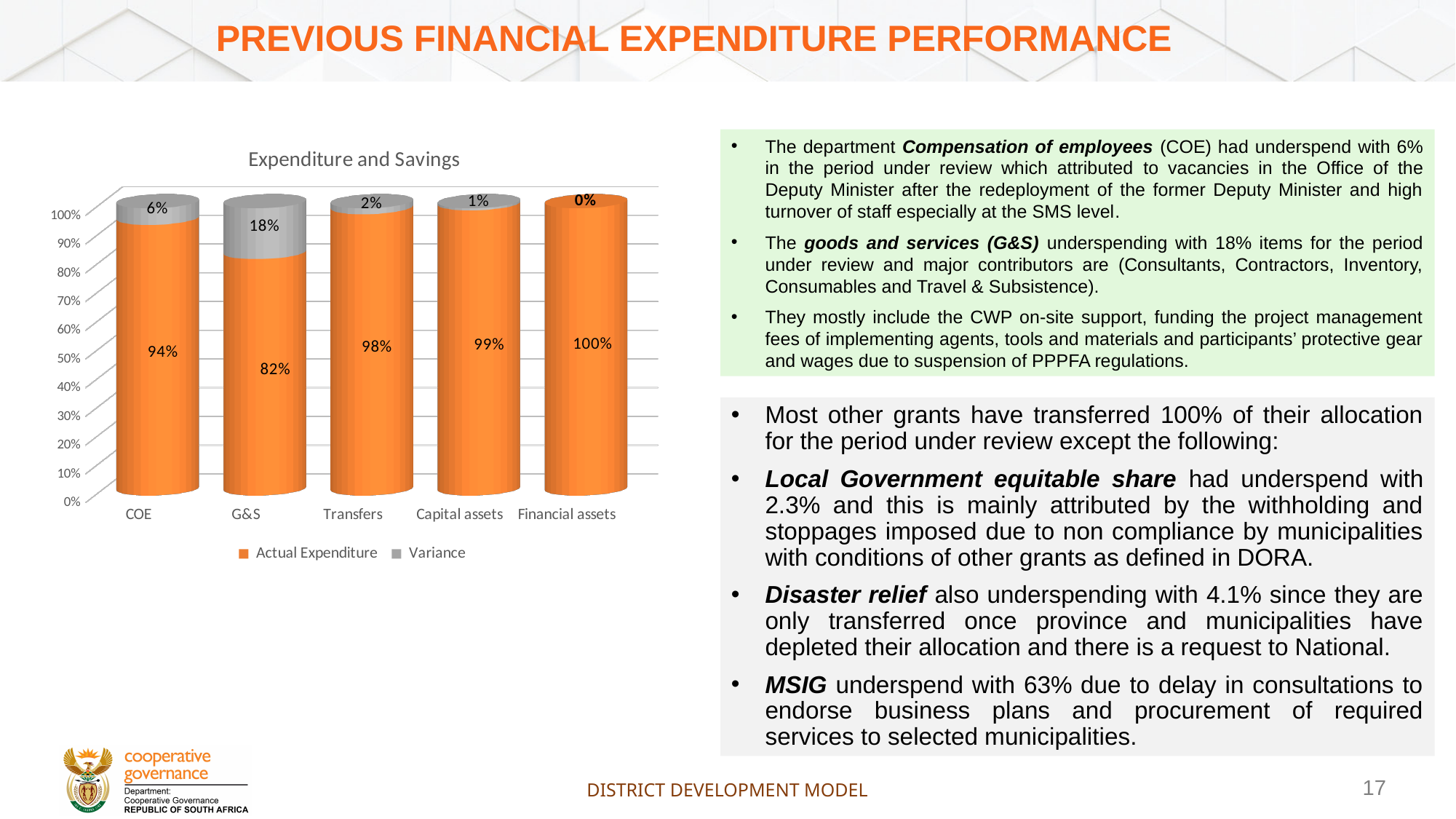
What kind of chart is shown? stacked bar chart What is the difference between the Actual Expenditure for Financial assets and for COE? 6% Which category has the lowest Actual Expenditure? G&S Which category has the highest Variance? G&S Is the Actual Expenditure for G&S larger or smaller than that for Capital assets? smaller What is the Variance value for G&S? 18% What is the Variance value for Capital assets? 1% How many series does the legend list? 2 How many categories are shown on the x axis? 5 What is the title of the chart? Expenditure and Savings What is the Actual Expenditure value for Transfers? 98% What is the Actual Expenditure value for COE? 94%